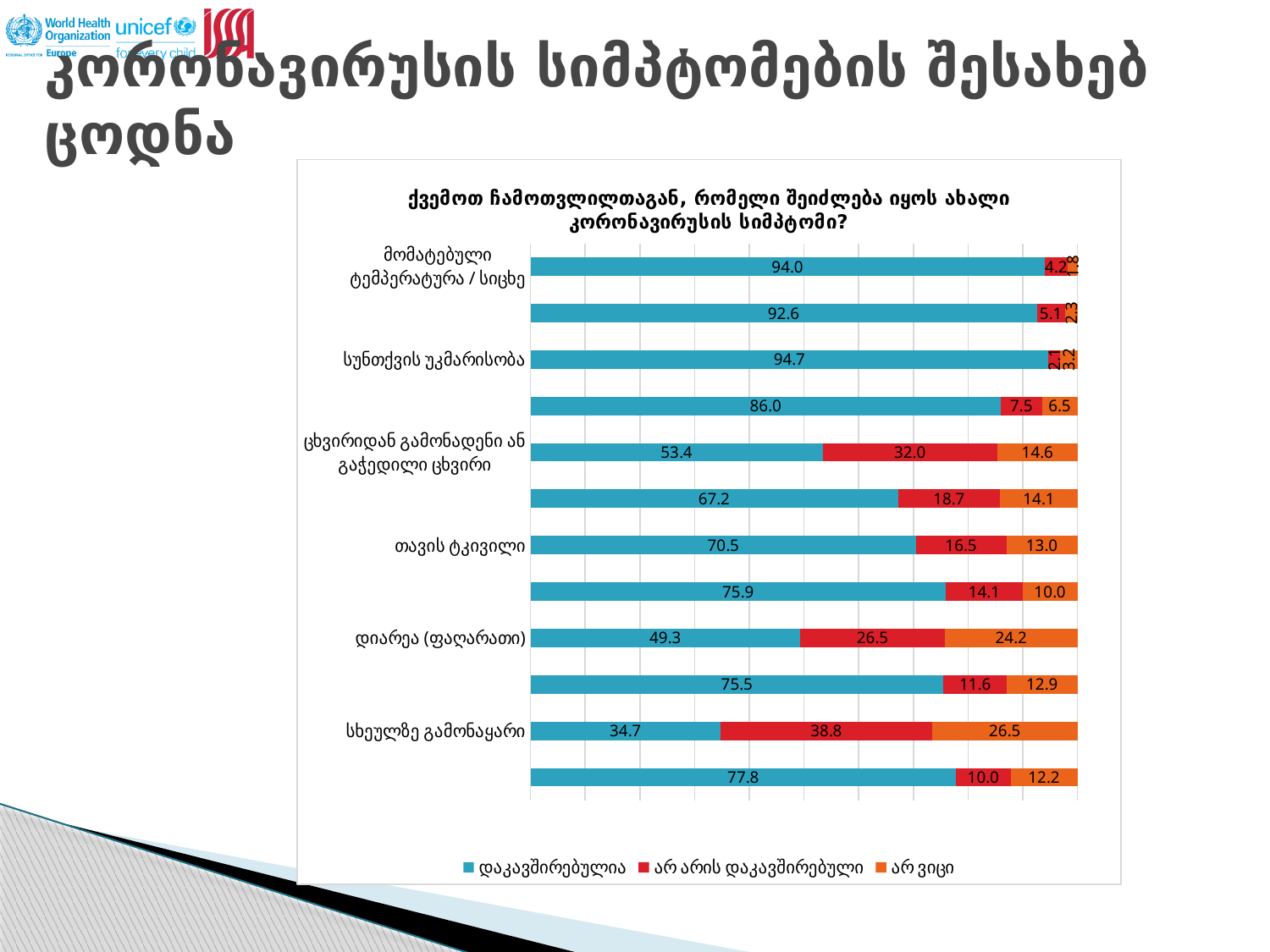
What is the value of the არ ვიცი series for დიარეა (ფაღარათი)? 24.2 Among the labelled categories, which has the highest value for the არ არის დაკავშირებული series? სხეულზე გამონაყარი What is the value of the დაკავშირებულია series for სუნთქვის უჭმარისობა? 94.7 What kind of chart is shown on the slide? Stacked bar chart For თავის ტკივილი, what is the difference between the დაკავშირებულია value and the არ არის დაკავშირებული value? 54.0 Among the labelled categories, which has the lowest value for the დაკავშირებულია series? სხეულზე გამონაყარი What is the value of the დაკავშირებულია series for მომატებული ტემპერატურა / სიცხე? 94.0 How many series does the legend list? 3 What colour represents the არ ვიცი series in the legend? Orange What is the value of the არ არის დაკავშირებული series for სხეულზე გამონაყარი? 38.8 What is the total of the stacked bar for სხეულზე გამონაყარი? 100.0 Which has a larger არ არის დაკავშირებული value: ცხვირიდან გამონადენი ან გაჭედილი ცხვირი or დიარეა (ფაღარათი)? ცხვირიდან გამონადენი ან გაჭედილი ცხვირი